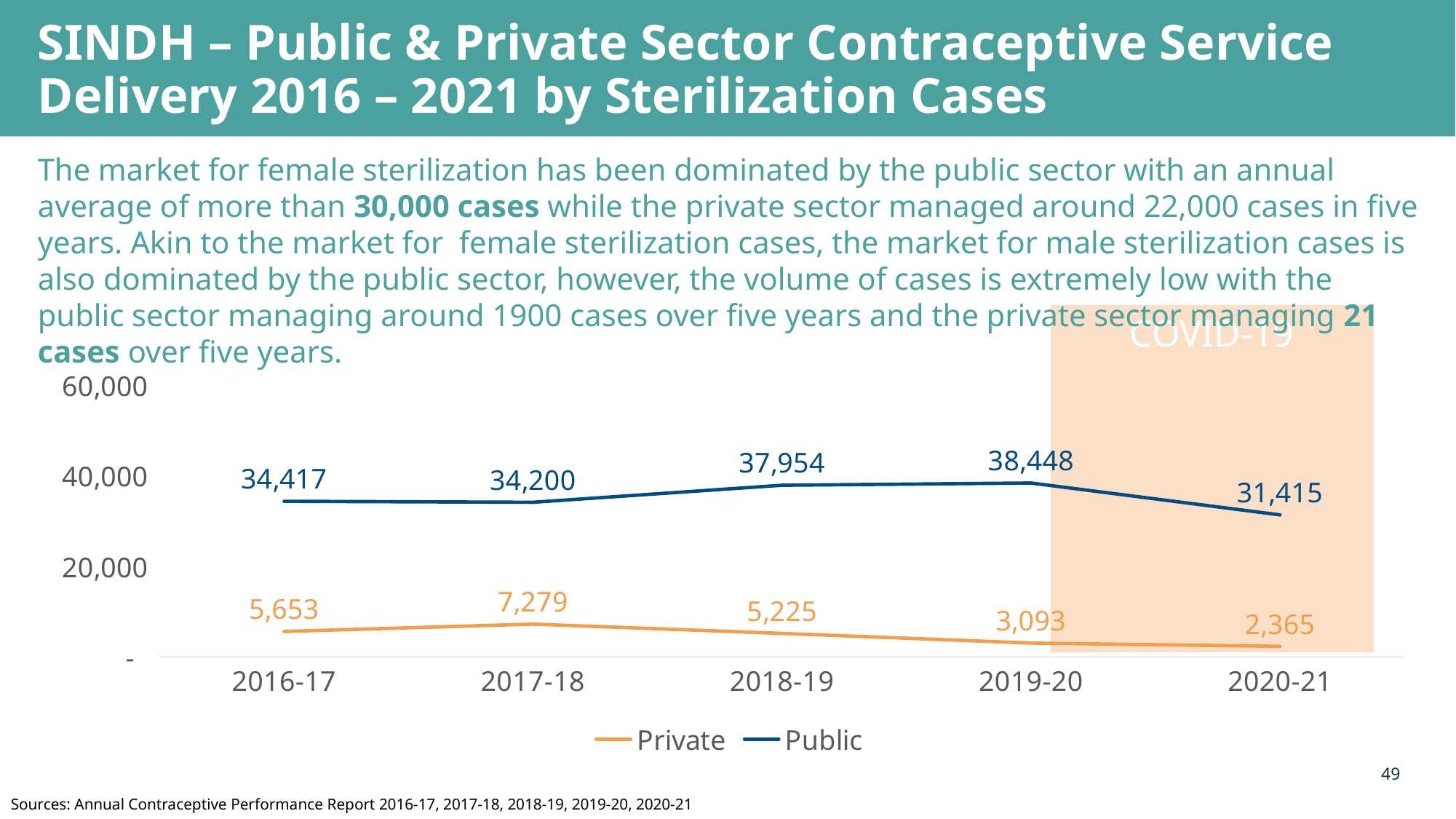
What is the Private value for 2017-18? 7,279 Is the Public value for 2018-19 greater or less than 20,000? greater What kind of chart is shown on the slide? line chart What is the difference between the Public and Private values in 2016-17? 28,764 In which year is the Private series lowest? 2020-21 How many series does the legend list? 2 Does the Private series rise or fall from 2017-18 to 2020-21? fall What is the Public value for 2019-20? 38,448 How many years are shown on the x axis? 5 What is the Public value for 2020-21? 31,415 Which is larger, the Private value in 2017-18 or the Private value in 2018-19? 2017-18 In which year is the Public series highest? 2019-20